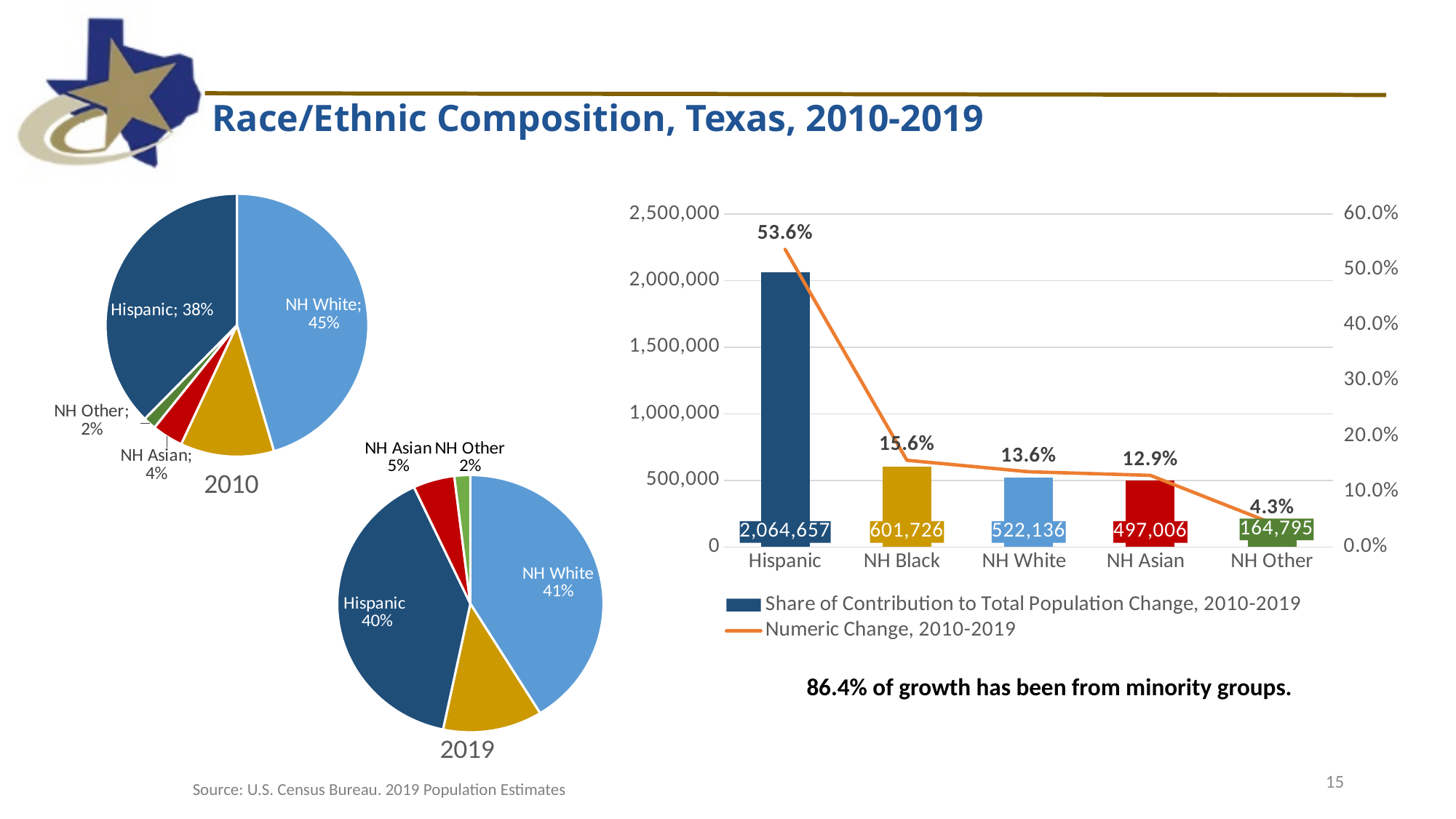
In the bar chart on the right, what percentage is labeled above NH Black? 15.6% In the bar chart on the right, which category has the tallest bar? Hispanic In the bar chart on the right, what is the data label on the bar for NH Other? 164,795 In the 2010 pie chart, which labeled slice is the smallest? NH Other In the bar chart on the right, how many categories are shown on the x axis? 5 In the 2019 pie chart, which labeled slice is the largest? NH White In the 2019 pie chart, what share is labeled for Hispanic? 40% In the bar chart on the right, what is the data label on the bar for Hispanic? 2,064,657 In the 2019 pie chart, what share is labeled for NH Asian? 5% In the 2010 pie chart, what share is labeled for NH White? 45% In the bar chart on the right, what is the difference between the bar labels for NH Black and NH White? 79,590 In the 2010 pie chart, what share is labeled for Hispanic? 38%